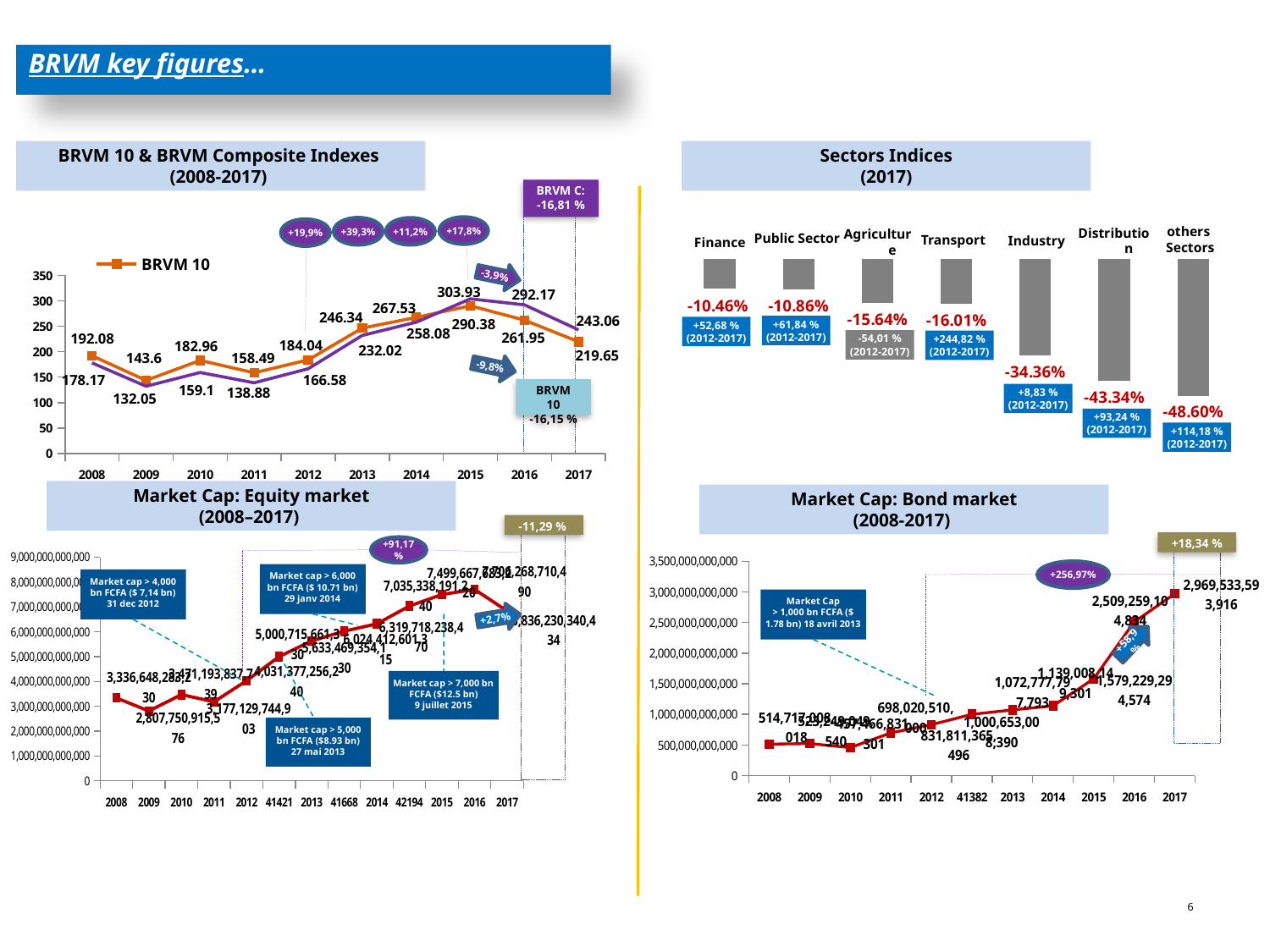
What kind of chart is the 'Sectors Indices (2017)' chart? bar chart On the 'Sectors Indices (2017)' chart, what is the value shown for Industry? -34.36% On the 'Sectors Indices (2017)' chart, which sector has the lowest value? others Sectors On the 'Sectors Indices (2017)' chart, which sector has the highest value? Finance On the 'BRVM 10 & BRVM Composite Indexes (2008-2017)' chart, what is the BRVM 10 value for 2017? 219.65 On the 'Sectors Indices (2017)' chart, which is larger, the value for Transport or the value for Distribution? Transport On the 'Sectors Indices (2017)' chart, how many sectors are shown? 7 On the 'Sectors Indices (2017)' chart, what is the value shown for Finance? -10.46% On the 'BRVM 10 & BRVM Composite Indexes (2008-2017)' chart, how many years are shown on the x axis? 10 On the 'BRVM 10 & BRVM Composite Indexes (2008-2017)' chart, what is the BRVM Composite value for 2017? 243.06 What kind of chart is the 'Market Cap: Bond market (2008-2017)' chart? line chart On the 'Sectors Indices (2017)' chart, what 2012-2017 change is shown for Transport? +244,82 %